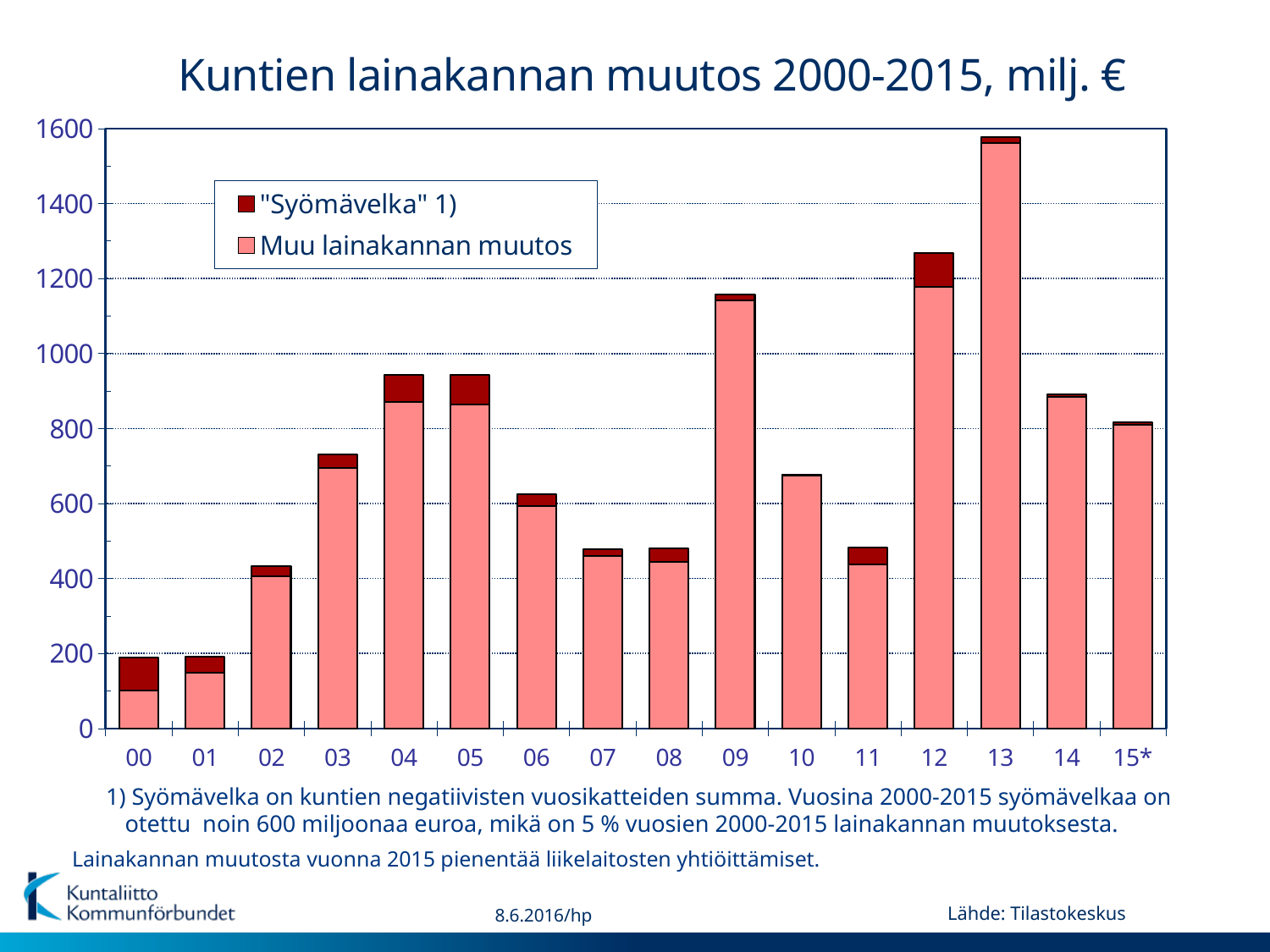
Is the total value for 09 greater or less than 1000? greater Is the total value for 14 greater or less than 1000? less What kind of chart is shown on the slide? bar chart How many years (categories) are shown on the x axis? 16 Is the total value for 12 greater or less than 1200? greater Which has the larger total bar, 14 or 15*? 14 What is the title of the chart? Kuntien lainakannan muutos 2000-2015, milj. € Which year has the highest total bar? 13 How many series does the legend list? 2 Which has the larger total bar, 09 or 10? 09